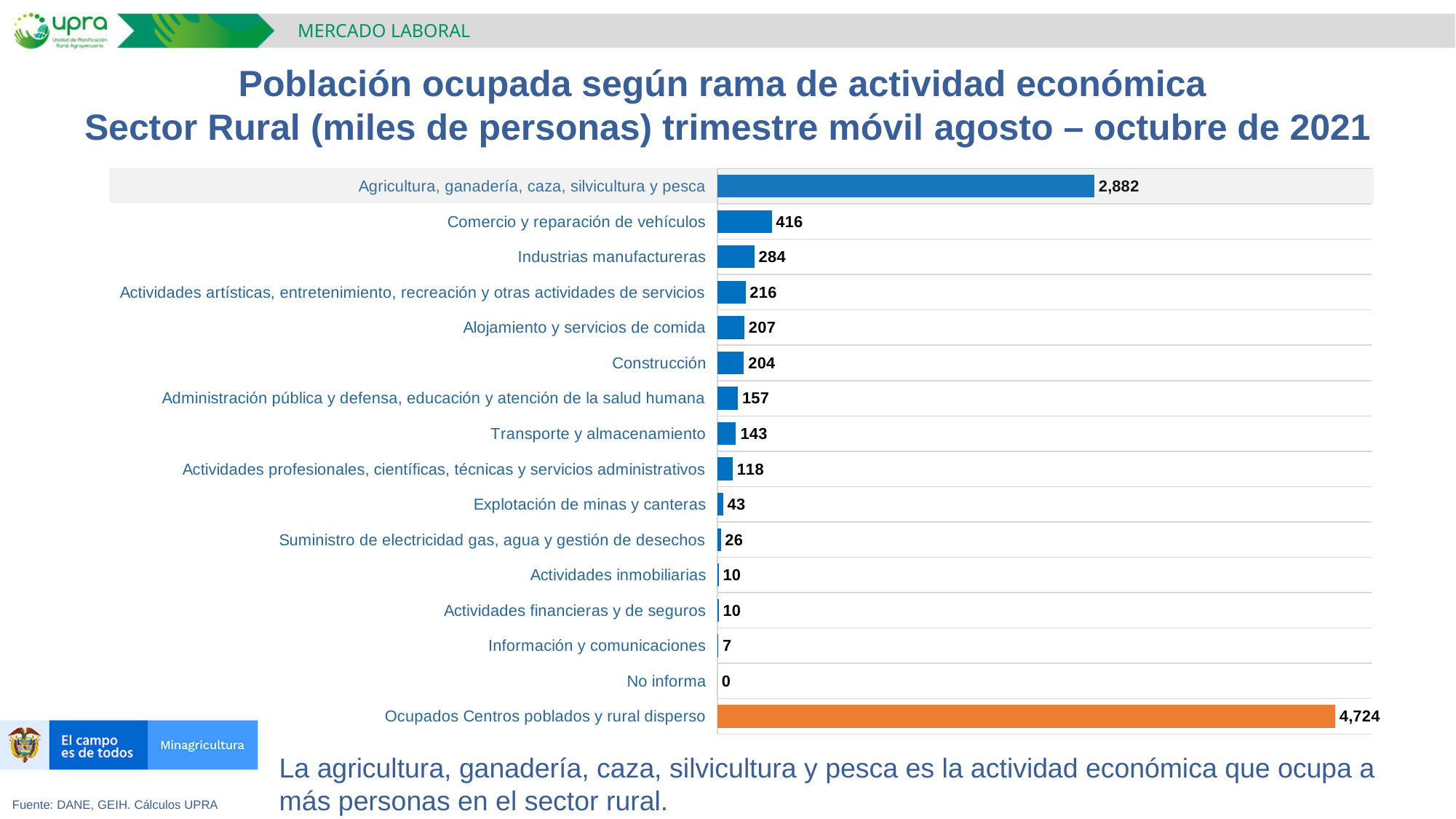
Which is larger, Transporte y almacenamiento or Actividades profesionales, científicas, técnicas y servicios administrativos? Transporte y almacenamiento What is the difference between Comercio y reparación de vehículos and Industrias manufactureras? 132 What is the value for Explotación de minas y canteras? 43 What kind of chart is shown on the slide? Bar chart Which bar is shown in orange rather than blue? Ocupados Centros poblados y rural disperso What is the value for Agricultura, ganadería, caza, silvicultura y pesca? 2,882 What is the value for Ocupados Centros poblados y rural disperso? 4,724 What is the difference between Alojamiento y servicios de comida and Construcción? 3 How many categories are shown in the chart? 16 Which category has the highest value in the chart? Ocupados Centros poblados y rural disperso Which category has the lowest value in the chart? No informa What is the value for Comercio y reparación de vehículos? 416